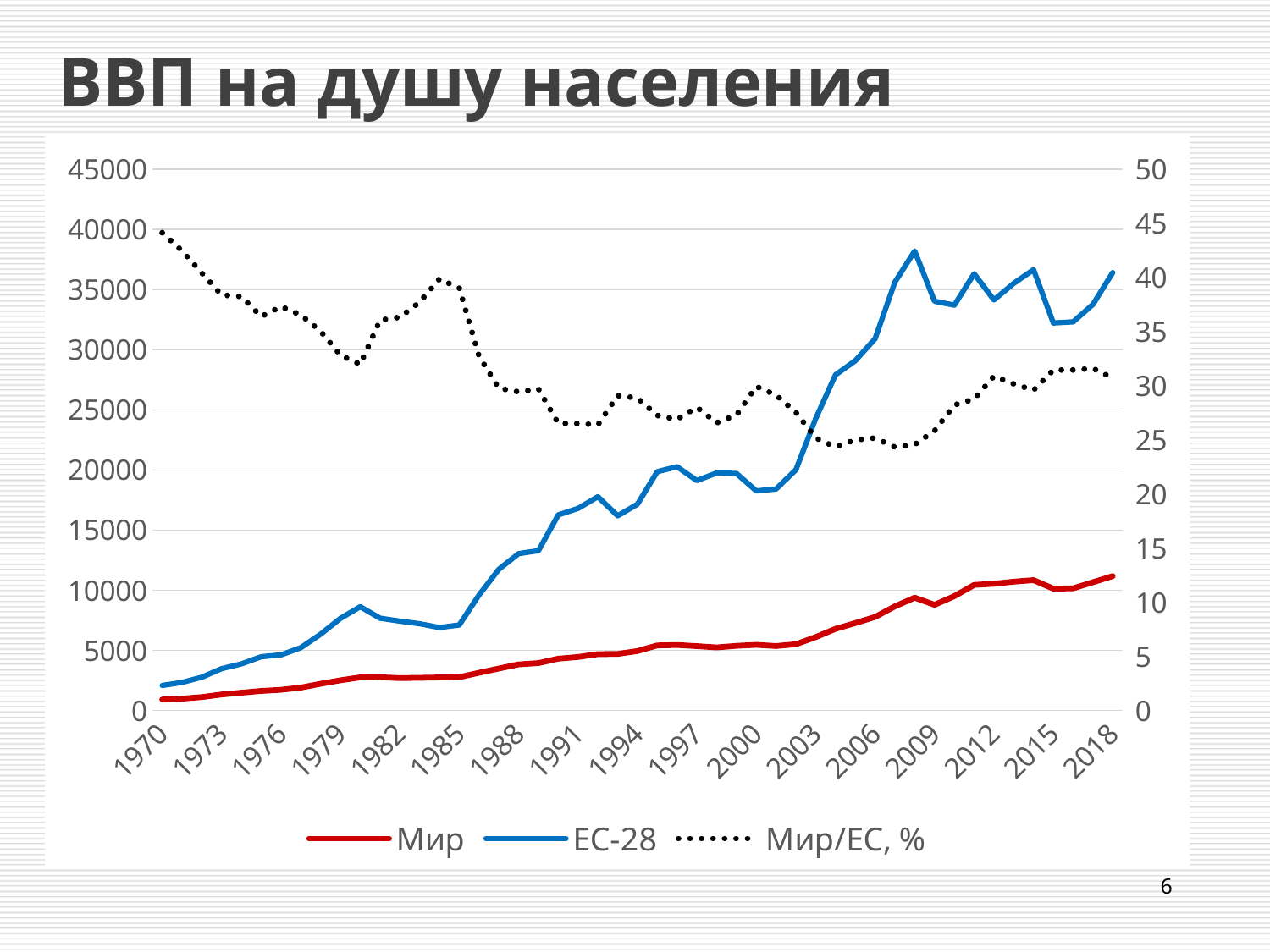
Is the value for Мир in 2018 greater or less than 15000? less Which series is drawn with a dotted line? Мир/ЕС, % Does the Мир series rise or fall overall from 1970 to 2018? rise Does the Мир/ЕС, % series rise or fall overall from 1970 to 2018? fall Is the value for ЕС-28 in 1985 greater or less than 10000? less Is the value for ЕС-28 in 2018 greater or less than 30000? greater What kind of chart is shown on the slide? line chart In 2018, which series has the higher value, Мир or ЕС-28? ЕС-28 How many series does the legend list? 3 What is the title of the chart? ВВП на душу населения